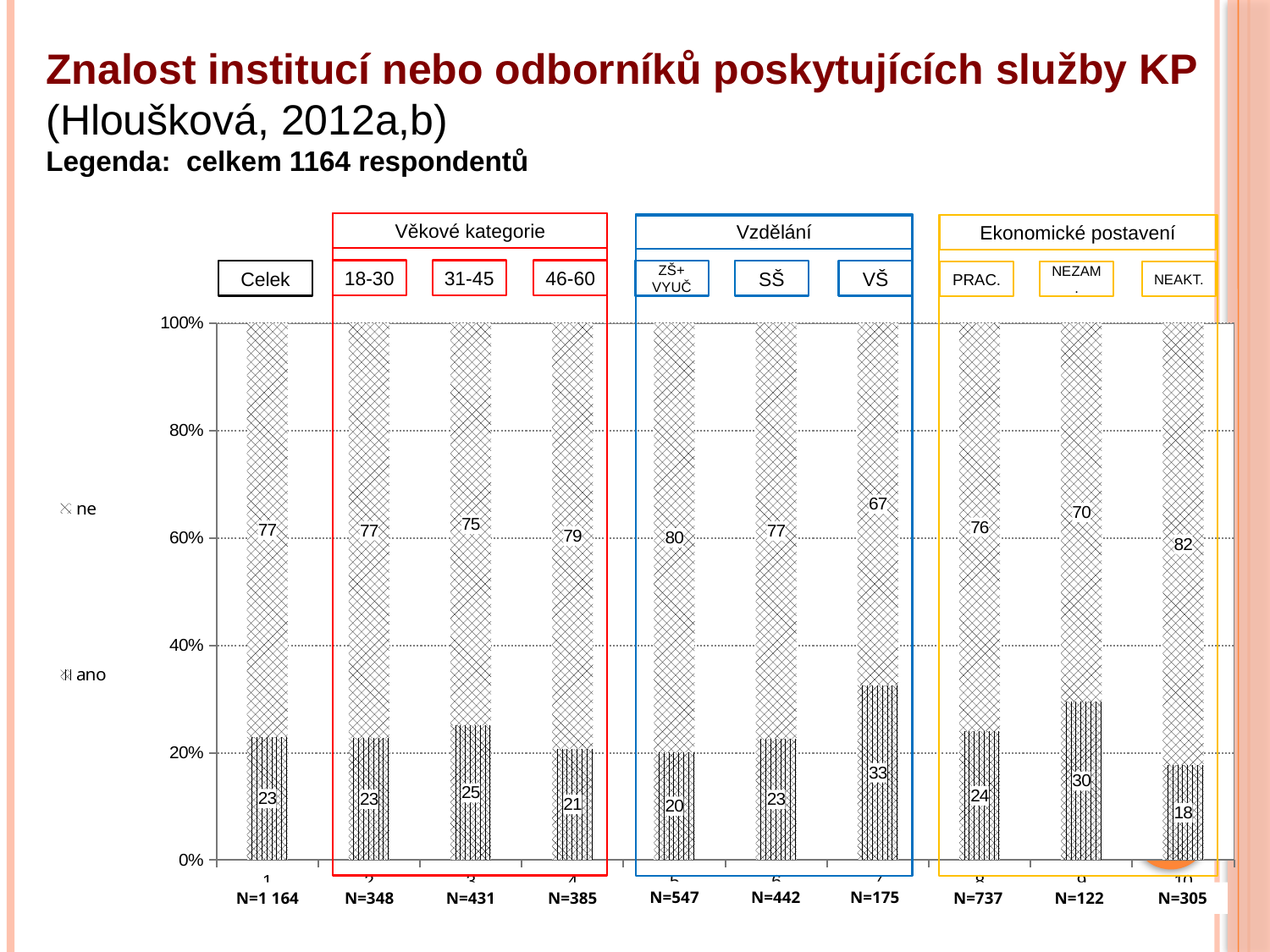
What is the "ano" value for the VŠ category? 33 Which has a larger "ne" value, 46-60 or 31-45? 46-60 What kind of chart is shown on the slide? stacked bar chart How many series does the legend list? 2 How many bars (categories) are plotted in the chart? 10 What is the total of the stacked bar for the SŠ category? 100 What is the "ne" value for the NEAKT. category? 82 What is the "ano" value for the Celek bar? 23 Which category has the highest "ano" value? VŠ What is the N (number of respondents) shown under the 18-30 bar? N=348 What is the difference between the "ano" values for NEZAM. and PRAC.? 6 Which category has the lowest "ano" value? NEAKT.